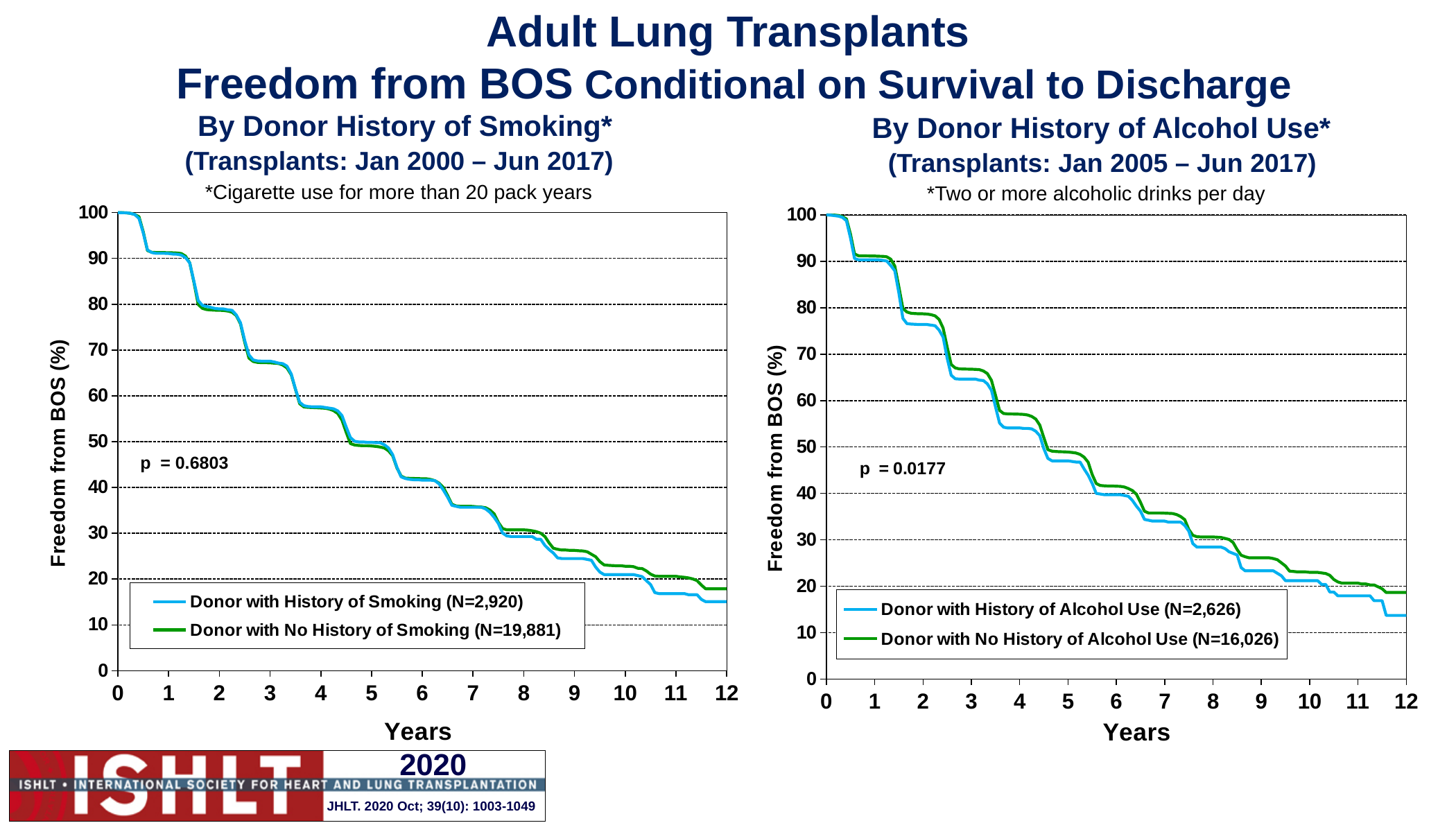
In the 'By Donor History of Alcohol Use' chart, at year 6, which series has the higher freedom from BOS: donors with a history of alcohol use or donors with no history of alcohol use? Donor with No History of Alcohol Use In the 'By Donor History of Smoking' chart, what is the p-value shown? p = 0.6803 In the 'By Donor History of Alcohol Use' chart, what is the N for donors with no history of alcohol use? N=16,026 In the 'By Donor History of Smoking' chart, is the freedom from BOS for donors with no history of smoking at year 4 greater or less than 50? greater How many series does the legend of the 'By Donor History of Alcohol Use' chart list? 2 In the 'By Donor History of Alcohol Use' chart, is the freedom from BOS for donors with a history of alcohol use at year 12 greater or less than 20? less In the 'By Donor History of Alcohol Use' chart, is the freedom from BOS for donors with a history of alcohol use at year 9 greater or less than 30? less What kind of chart is the 'By Donor History of Smoking' chart on the left? line chart In the 'By Donor History of Smoking' chart, what is the N for donors with a history of smoking? N=2,920 In the 'By Donor History of Smoking' chart, do the curves rise or fall as years increase? fall In the 'By Donor History of Alcohol Use' chart, what is the p-value shown? p = 0.0177 What colour is the line for 'Donor with History of Smoking' in the left chart? blue